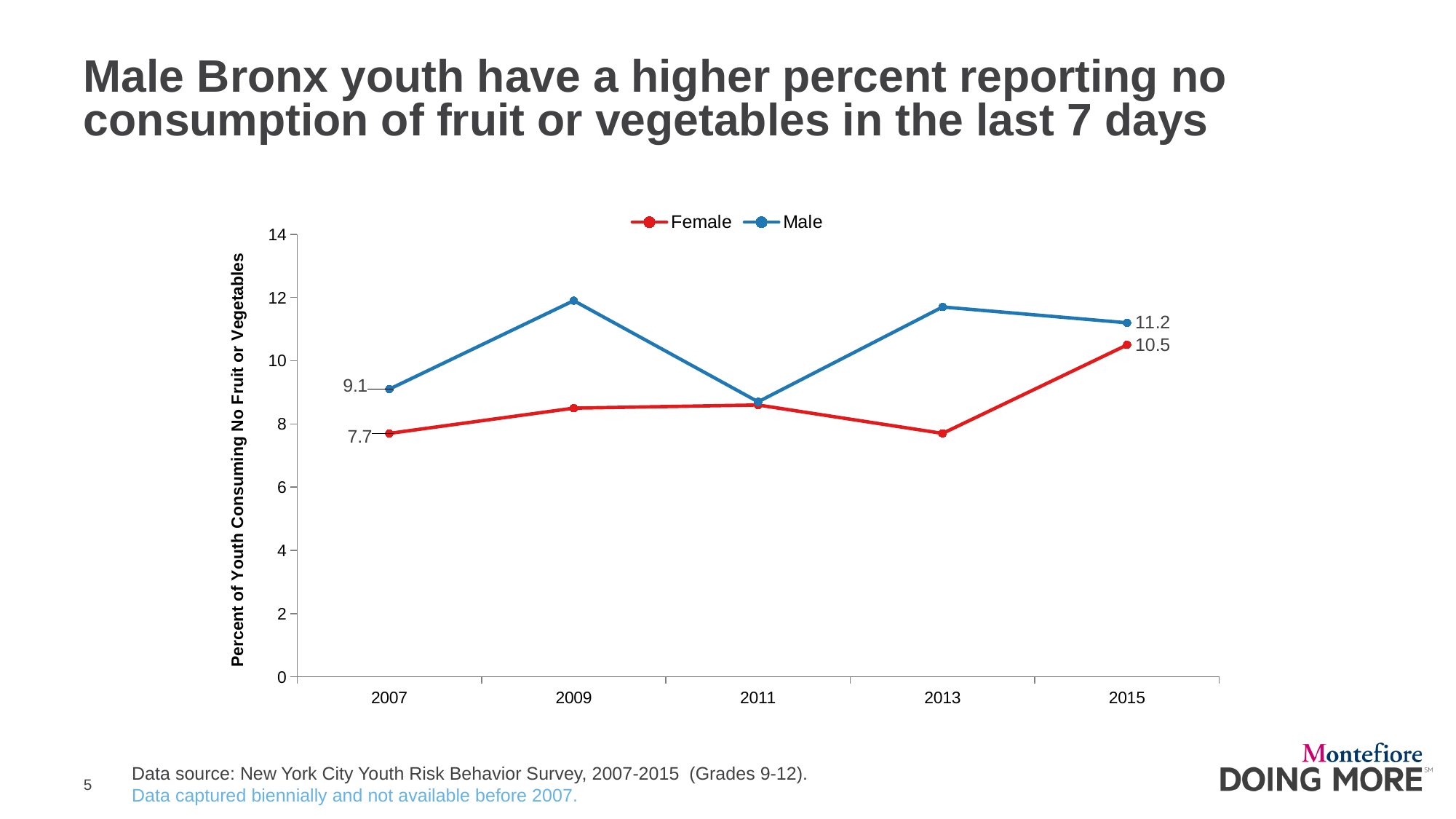
What kind of chart is shown on the slide? Line chart Is the value for Male in 2011 greater or less than 10? less How many series does the legend list? 2 What is the value for Male in 2015? 11.2 In 2015, which series has the larger value, Male or Female? Male What is the value for Male in 2007? 9.1 How many years are shown on the x axis? 5 Is the value for Male in 2009 greater or less than 10? greater What is the difference between the Male and Female values in 2015? 0.7 What is the value for Female in 2007? 7.7 What is the value for Female in 2015? 10.5 What is the difference between the Male and Female values in 2007? 1.4